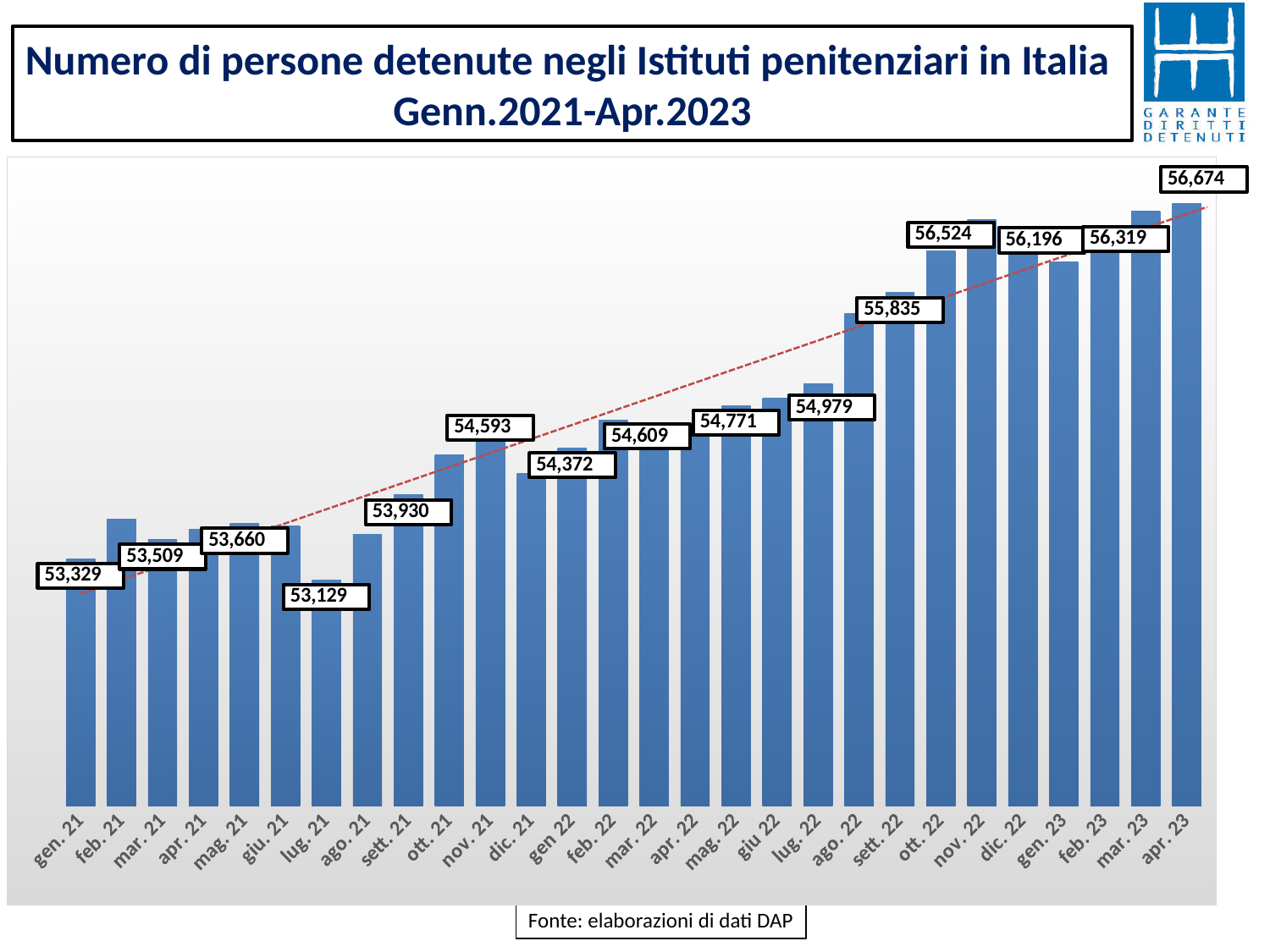
Which is larger, the value for mar. 23 or the value for gen. 23? mar. 23 Which month has the highest number of detained persons? apr. 23 What is the number of detained persons shown for apr. 23? 56,674 Which month has the lowest number of detained persons? lug. 21 Which is larger, the value for feb. 21 or the value for lug. 21? feb. 21 What is the difference between the values for gen. 21 and lug. 21? 200 Overall, do the values rise or fall from gen. 21 to apr. 23? rise What kind of chart is shown on the slide? bar chart What is the number of detained persons shown for gen. 21? 53,329 What is the difference between the values for apr. 23 and gen. 21? 3,345 What is the number of detained persons shown for lug. 21? 53,129 How many months (bars) are shown on the chart? 28